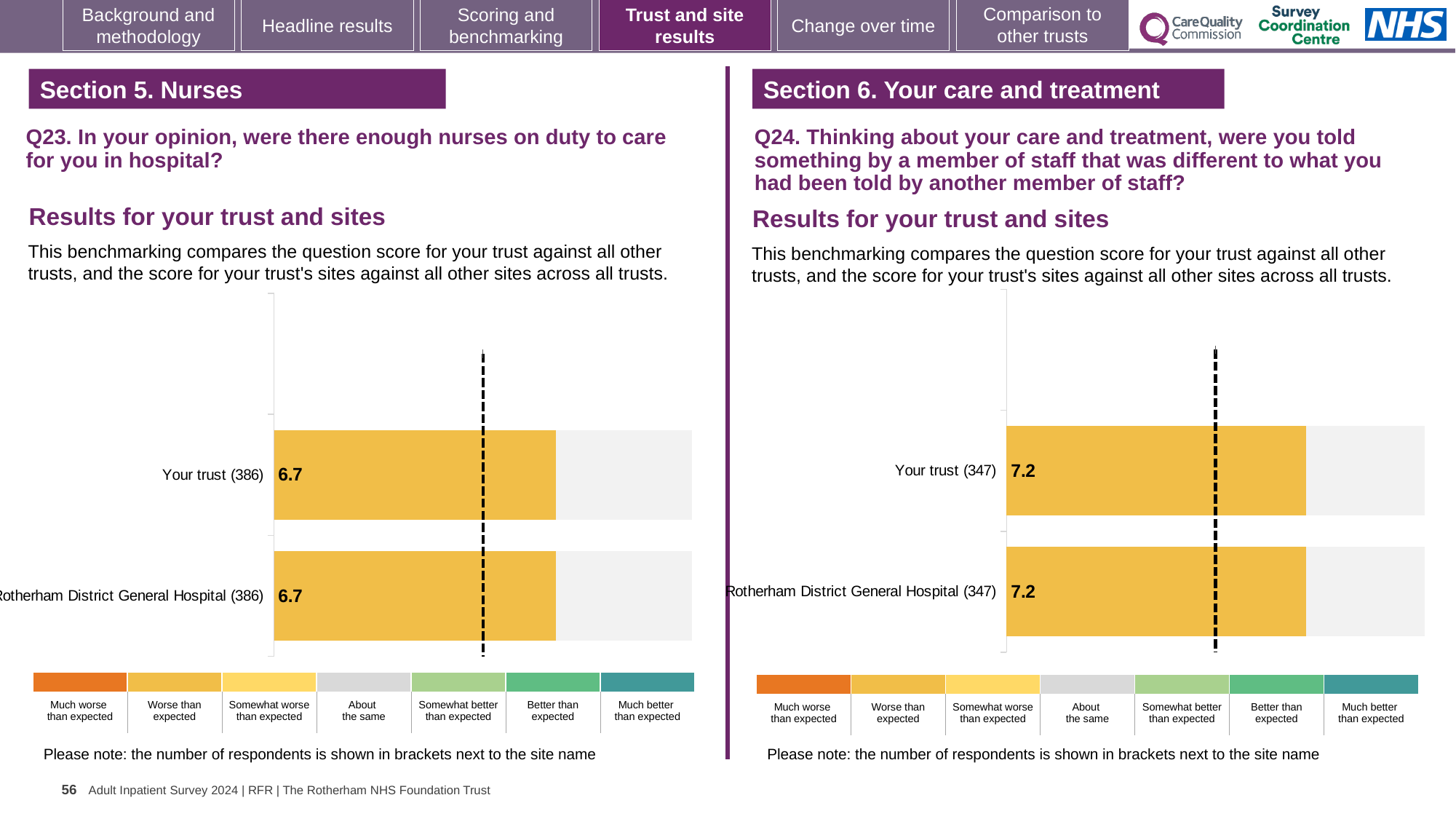
On the Q23 chart (Section 5. Nurses), what is the score for Rotherham District General Hospital? 6.7 On the Q23 chart (Section 5. Nurses), what is the difference between the score for Your trust and the score for Rotherham District General Hospital? 0.0 On the Q24 chart (Section 6. Your care and treatment), what colour are the bars for Your trust and Rotherham District General Hospital? Yellow/orange On the Q23 chart (Section 5. Nurses), how many respondents are shown in brackets next to Your trust? 386 What type of chart is used on the Q24 chart (Section 6. Your care and treatment)? Bar chart On the Q24 chart (Section 6. Your care and treatment), how many bars are plotted? 2 On the Q24 chart (Section 6. Your care and treatment), what is the score for Rotherham District General Hospital? 7.2 How many categories does the colour key below the Q23 chart (Section 5. Nurses) list? 7 On the Q23 chart (Section 5. Nurses), how many bars are plotted? 2 On the Q24 chart (Section 6. Your care and treatment), what is the score for Your trust? 7.2 On the Q24 chart (Section 6. Your care and treatment), how many respondents are shown in brackets next to Rotherham District General Hospital? 347 On the Q23 chart (Section 5. Nurses), what is the score for Your trust? 6.7